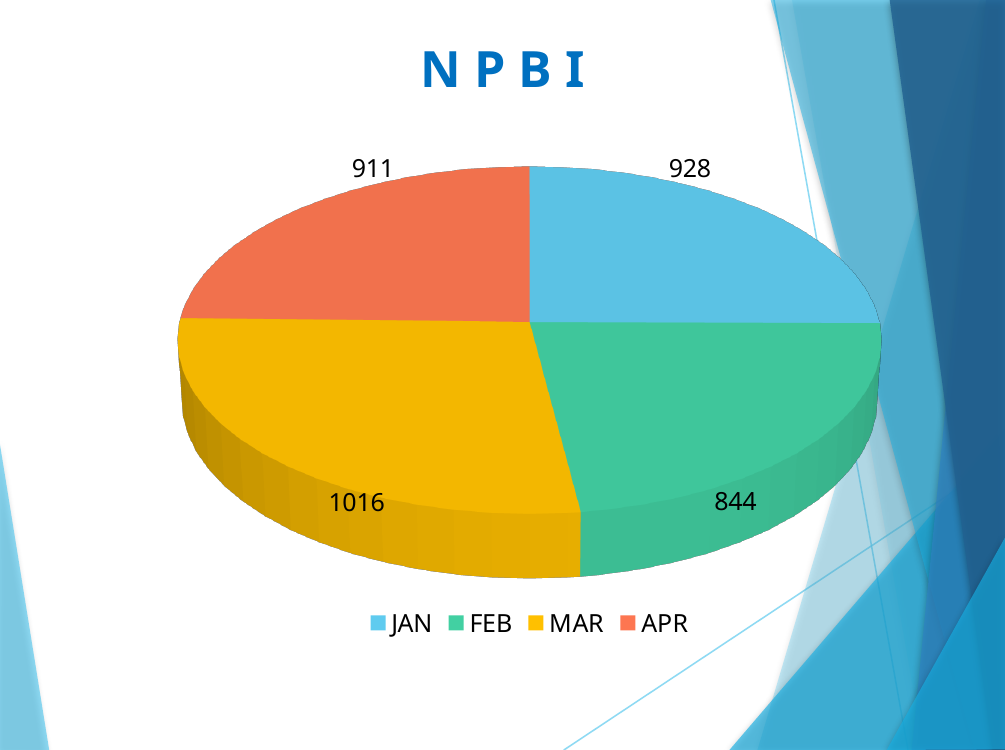
What type of chart is shown on the slide? pie chart What is the value for FEB? 844 What is the value for MAR? 1016 What is the value for APR? 911 What is the title of the chart? N P B I Which colour represents MAR in the legend? yellow Which month has the smallest slice? FEB What is the value for JAN? 928 How many slices does the pie chart have? 4 Which is larger, the value for JAN or the value for APR? JAN What is the difference between the values for MAR and FEB? 172 Which month has the largest slice? MAR